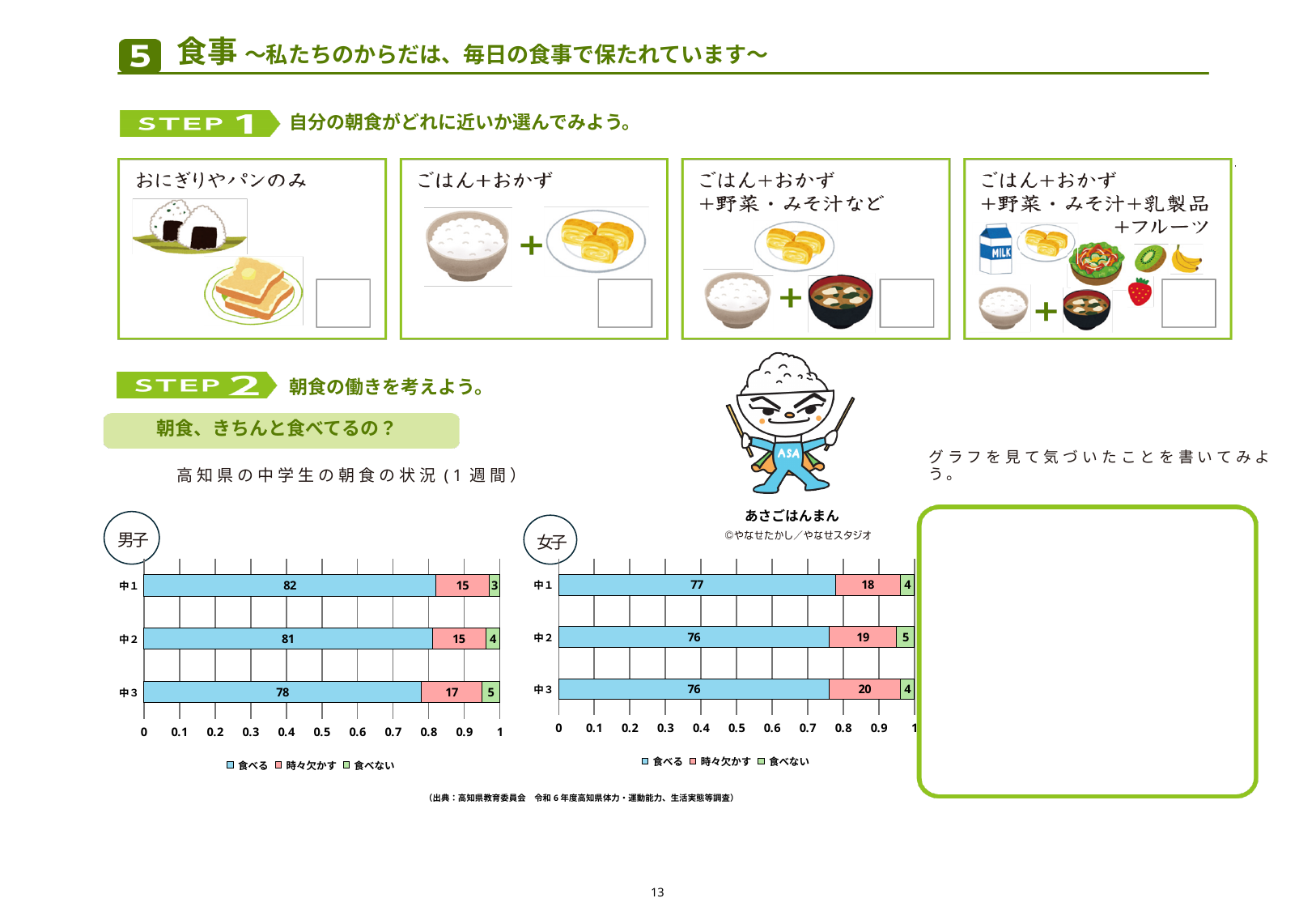
In the 男子 chart, does the 食べる value rise or fall from 中1 to 中3? Fall What is the total of the stacked bar for 中2 in the 女子 chart? 100 In the 女子 chart, which grade has the highest value for 食べる? 中1 How many grade categories are shown in the 女子 chart? 3 In the 男子 chart, which grade has the lowest value for 食べる? 中3 In the 男子 chart, what is the value of 食べない for 中3? 5 How many series does the legend of the 男子 chart list? 3 What type of chart is the 女子 chart? Stacked bar chart In the 女子 chart, what is the value of 時々欠かす for 中3? 20 Which is larger: the 食べる value for 中2 in the 男子 chart or the 食べる value for 中2 in the 女子 chart? 男子 (81) In the 男子 chart, what is the value of 食べる for 中1? 82 In the 男子 chart, what is the difference between the 食べる values for 中1 and 中3? 4